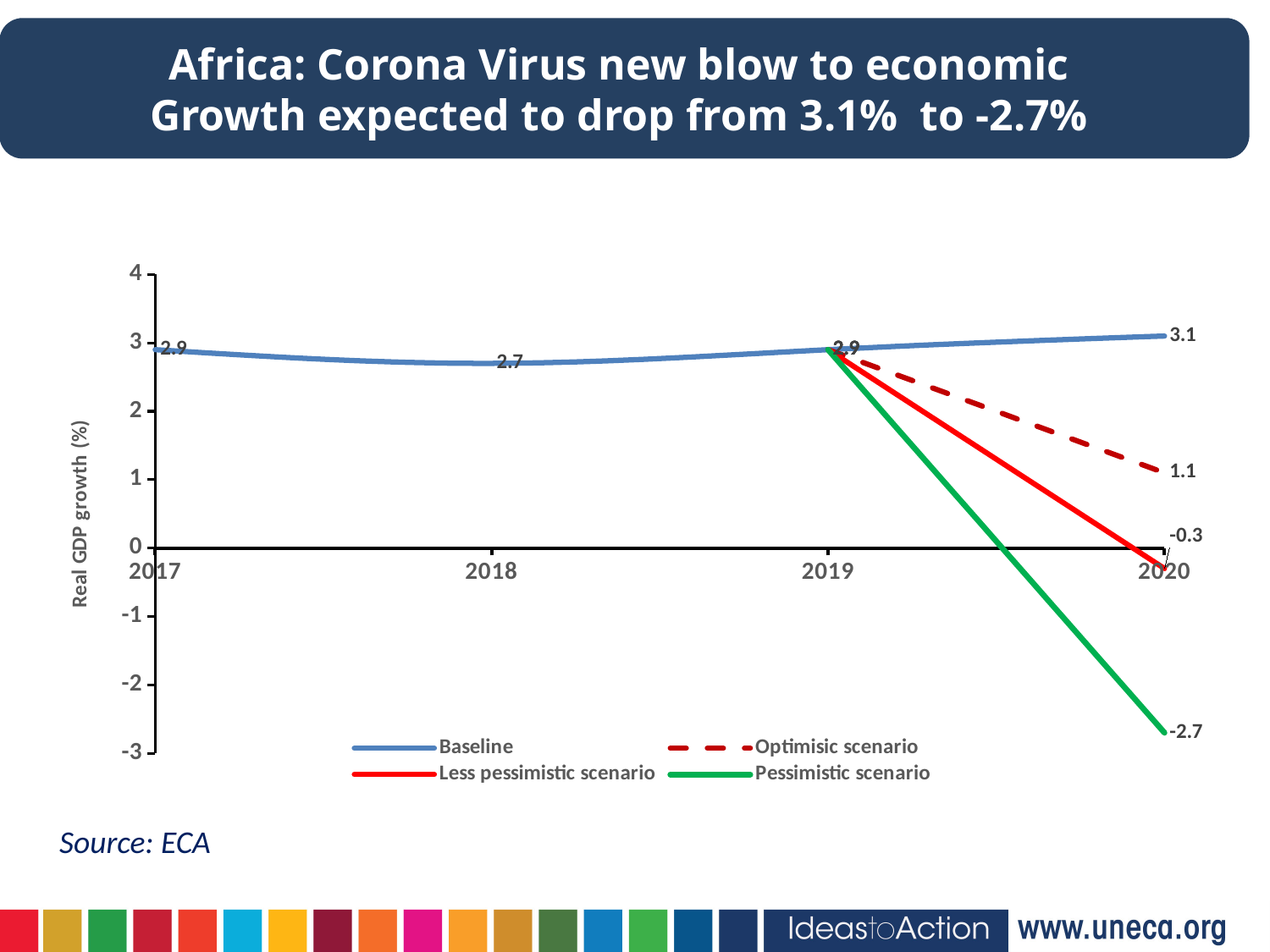
What is the Baseline value for 2018? 2.7 Which series has the lowest value in 2020? Pessimistic scenario Is the Baseline value for 2020 larger than the Optimisic scenario value for 2020? Yes What is the value of the Optimisic scenario in 2020? 1.1 How many series does the legend list? 4 What is the difference between the Baseline and the Pessimistic scenario values in 2020? 5.8 How many years are shown on the x axis? 4 What is the Baseline value for 2020? 3.1 What kind of chart is shown on the slide? line chart What is the value of the Less pessimistic scenario in 2020? -0.3 What is the value of the Pessimistic scenario in 2020? -2.7 Which series has the highest value in 2020? Baseline